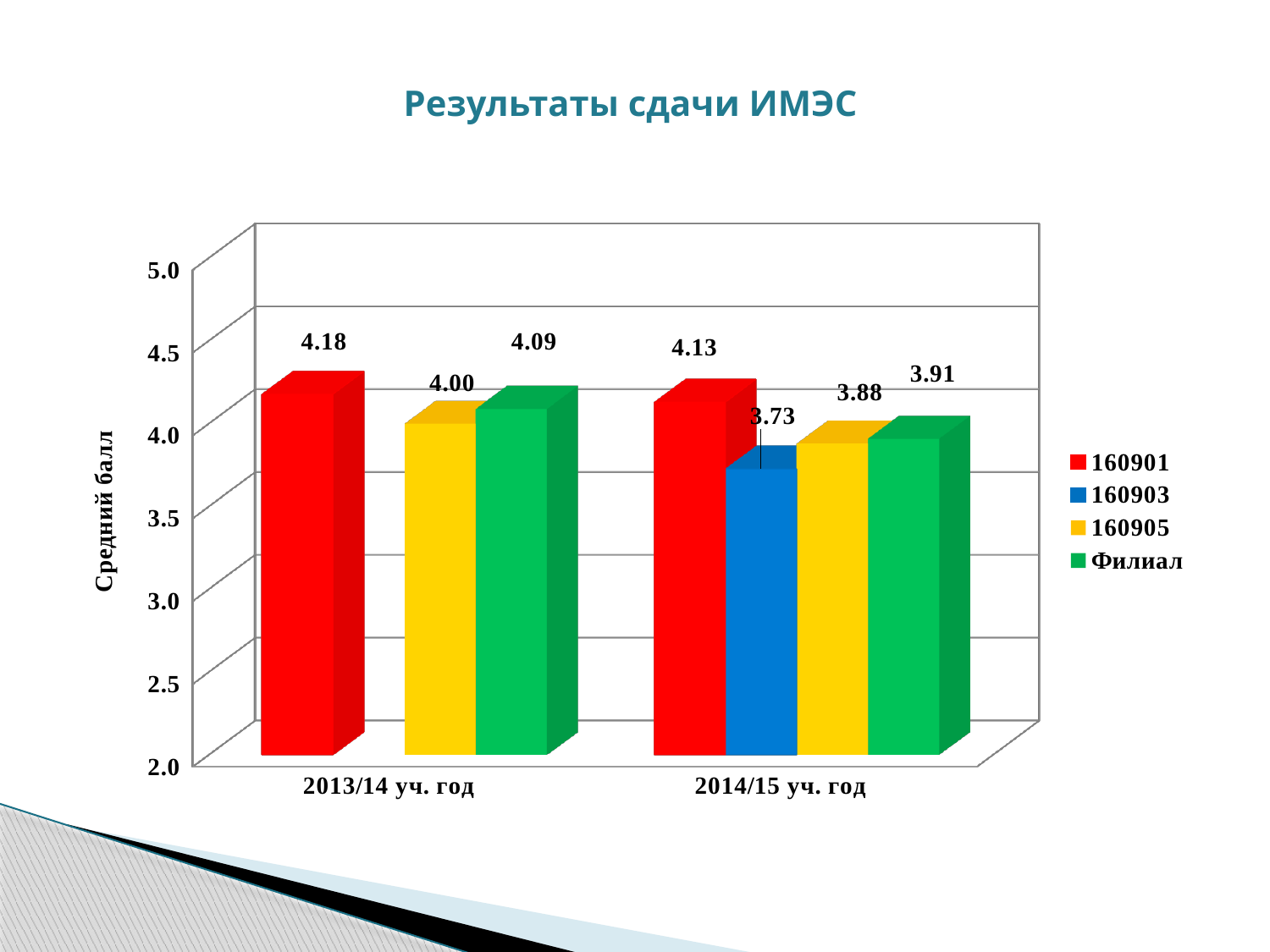
How many categories are shown on the x axis? 2 Which is larger: the Филиал value in 2013/14 уч. год or in 2014/15 уч. год? 2013/14 уч. год What is the value for 160905 in 2013/14 уч. год? 4.00 What is the title of the chart? Результаты сдачи ИМЭС What kind of chart is shown on the slide? Bar chart Which series has the lowest value in 2014/15 уч. год? 160903 Which series has the highest value in 2014/15 уч. год? 160901 How many series does the legend list? 4 What is the value for Филиал in 2014/15 уч. год? 3.91 What is the value for 160903 in 2014/15 уч. год? 3.73 What is the difference between the 160901 values for 2013/14 уч. год and 2014/15 уч. год? 0.05 What is the value for 160901 in 2013/14 уч. год? 4.18